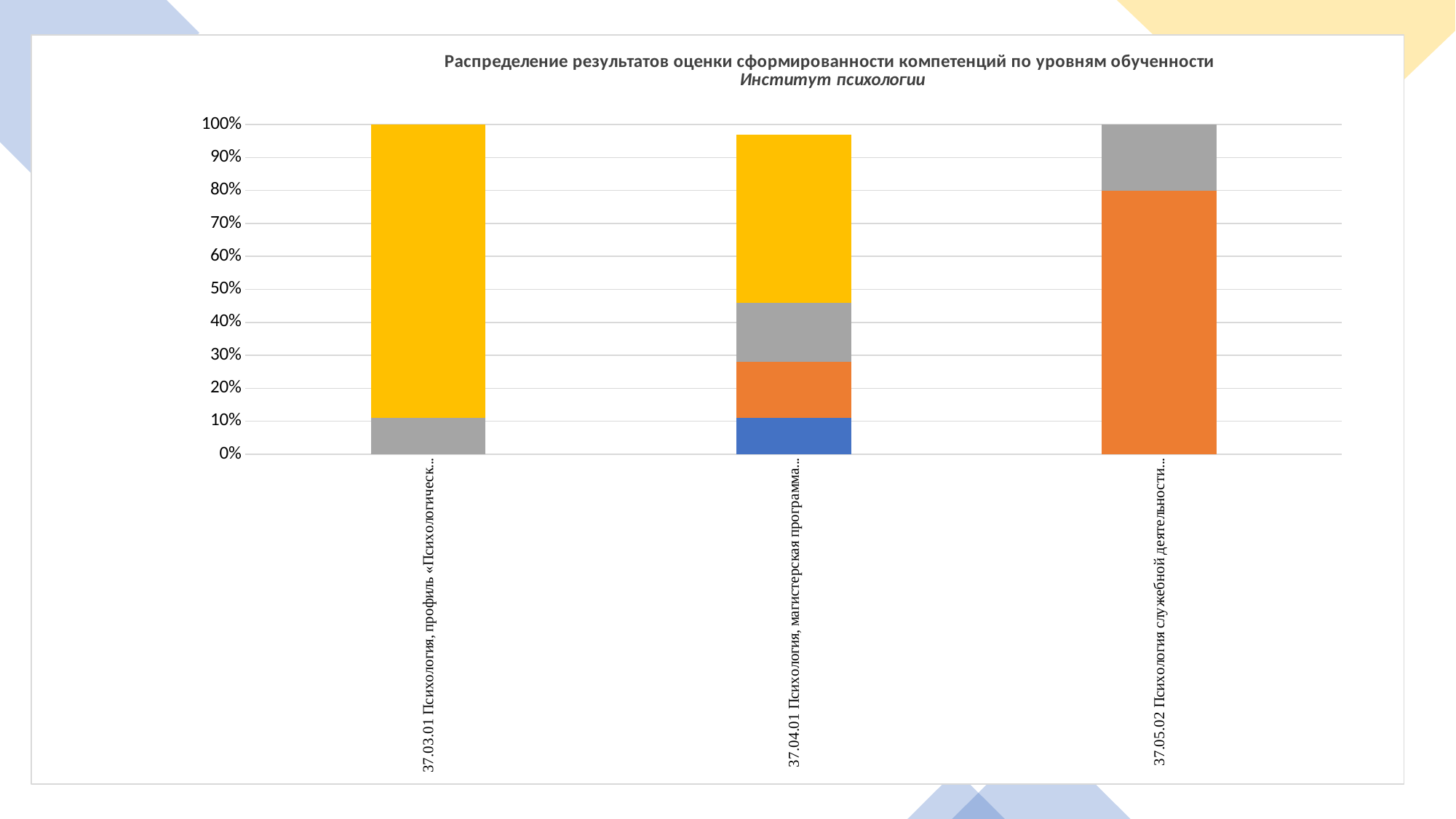
How many bars (categories) are plotted in the chart? 3 What kind of chart is shown on the slide? Stacked bar chart Is the yellow segment of the 37.04.01 bar greater or less than 40%? greater Which category's bar contains no yellow segment? 37.05.02 Психология служебной деятельности... Is the grey segment of the 37.03.01 bar greater or less than 20%? less Is the orange segment of the 37.04.01 bar greater or less than 30%? less Which category's bar contains a blue segment? 37.04.01 Психология, магистерская программа... What is the subtitle (second line of the title) of the chart? Институт психологии Which category's bar has the largest orange segment? 37.05.02 Психология служебной деятельности... Which category's bar has the largest yellow segment? 37.03.01 Психология, профиль «Психологическ...